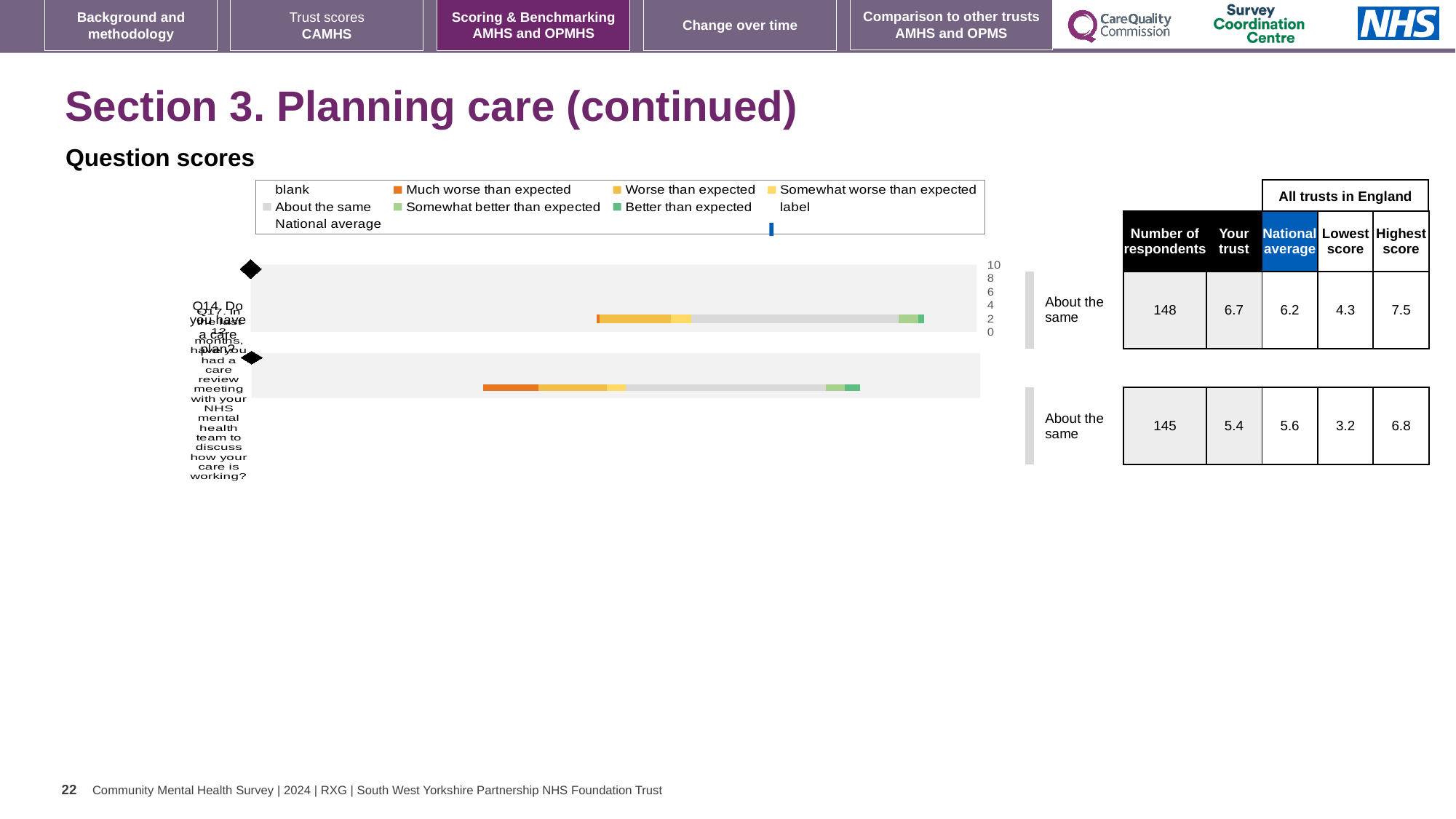
For the first row (Q14), which is larger: the 'Your trust' score or the national average? Your trust In the chart legend, what colour represents 'Much worse than expected'? orange For the second row (Q17), which is larger: the 'Your trust' score or the national average? National average What benchmark label is shown next to the second bar (Q17)? About the same In the chart legend, what colour represents 'Better than expected'? green What kind of chart is shown on the slide? bar chart How many question bars are plotted in the chart? 2 In the table beside the chart, what is the number of respondents for the first row (Q14)? 148 In the table beside the chart, what is the 'Your trust' score for the first row (Q14)? 6.7 In the table beside the chart, what is the national average for the second row (Q17)? 5.6 For the first row (Q14), what is the difference between the highest score and the lowest score in the table? 3.2 In the table beside the chart, what is the highest score for the second row (Q17)? 6.8